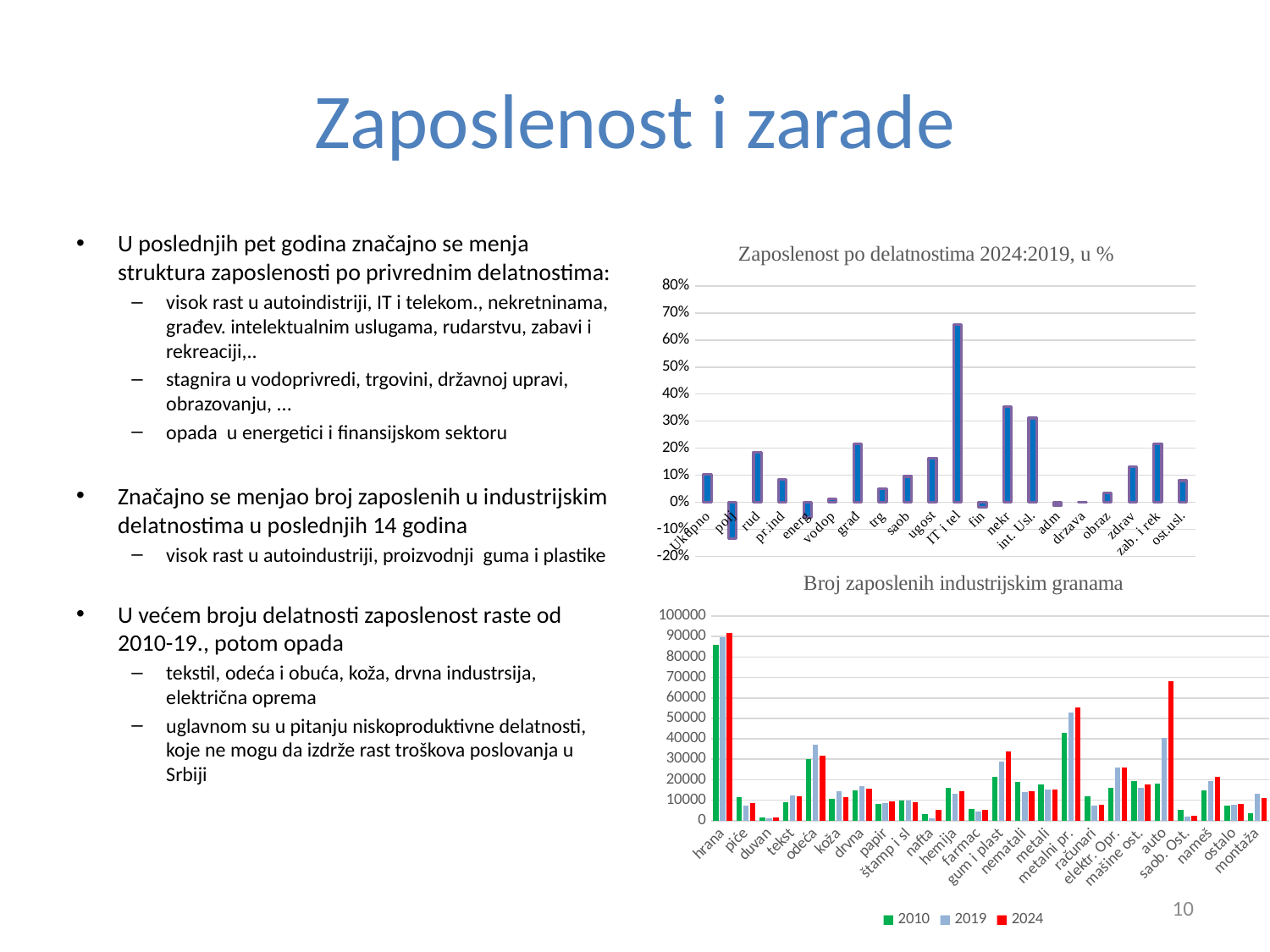
In the chart "Zaposlenost po delatnostima 2024:2019, u %", which category has the highest value? IT i tel In the chart "Zaposlenost po delatnostima 2024:2019, u %", is the value for IT i tel greater or less than 60%? greater What kind of chart is the chart titled "Zaposlenost po delatnostima 2024:2019, u %"? bar chart In the chart "Broj zaposlenih industrijskim granama", which category has the highest bar overall? hrana In the chart "Zaposlenost po delatnostima 2024:2019, u %", which category has the lowest value? polj How many categories are shown on the x axis of the chart "Zaposlenost po delatnostima 2024:2019, u %"? 20 How many series does the legend of the chart "Broj zaposlenih industrijskim granama" list? 3 In the chart "Zaposlenost po delatnostima 2024:2019, u %", which is larger, the value for grad or the value for trg? grad In the chart "Broj zaposlenih industrijskim granama", which is larger for odeća, the 2019 value or the 2024 value? 2019 In the chart "Broj zaposlenih industrijskim granama", is the 2024 value for auto greater or less than 60000? greater In the chart "Broj zaposlenih industrijskim granama", which series is shown in red? 2024 In the chart "Zaposlenost po delatnostima 2024:2019, u %", is the value for nekr greater or less than 30%? greater